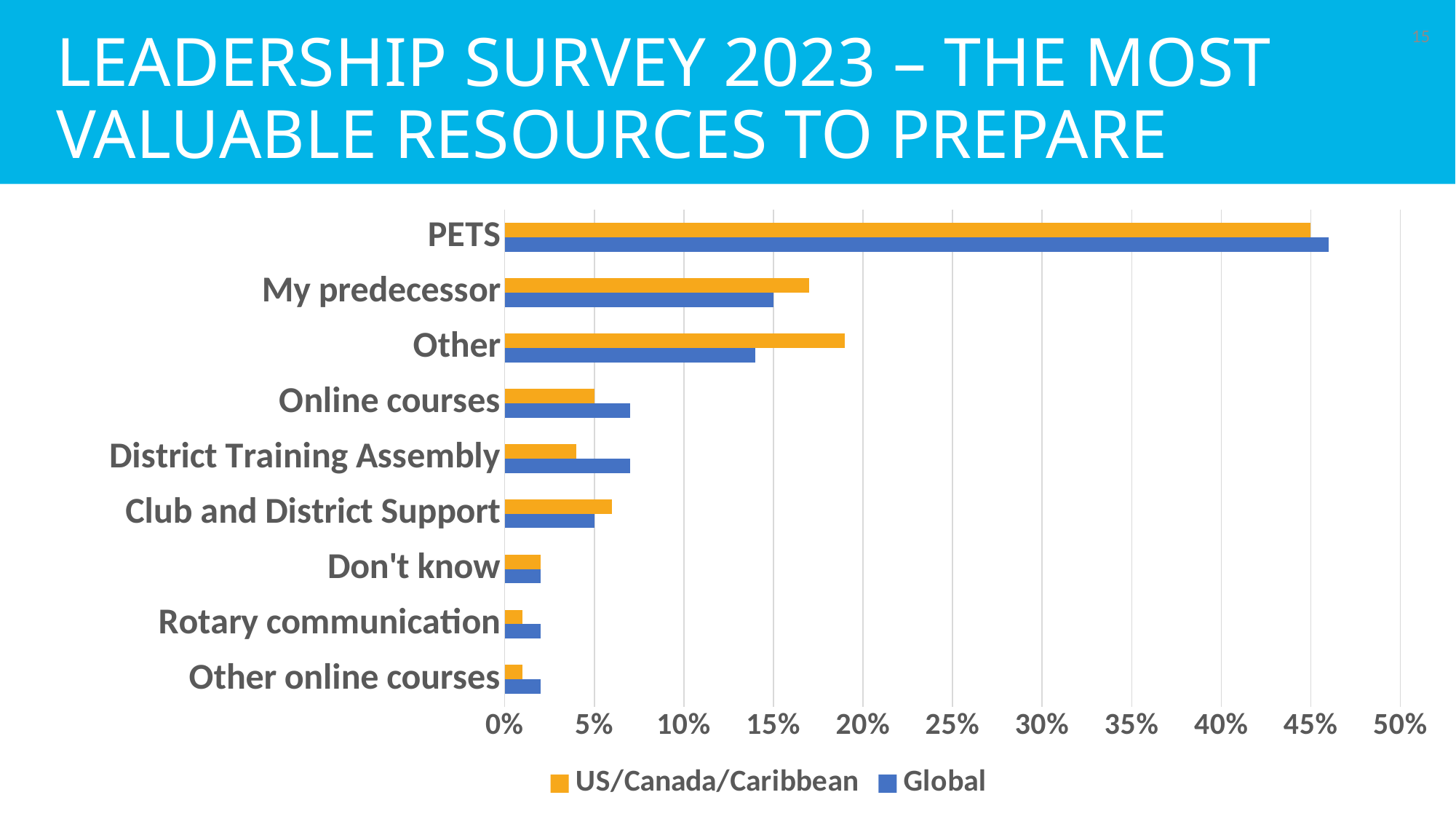
For Other, which series has the larger value, US/Canada/Caribbean or Global? US/Canada/Caribbean For My predecessor, which series has the larger value, US/Canada/Caribbean or Global? US/Canada/Caribbean Is the US/Canada/Caribbean value for Other greater or less than 15%? greater For District Training Assembly, which series has the larger value, US/Canada/Caribbean or Global? Global What kind of chart is shown on the slide? Bar chart How many series does the legend list? 2 Is the Global value for Online courses greater or less than 10%? less How many resource categories are plotted on the chart? 9 Is the Global value for PETS greater or less than 40%? greater What colour are the bars for the Global series? Blue Which category has the highest US/Canada/Caribbean value? PETS Which category has the highest Global value? PETS